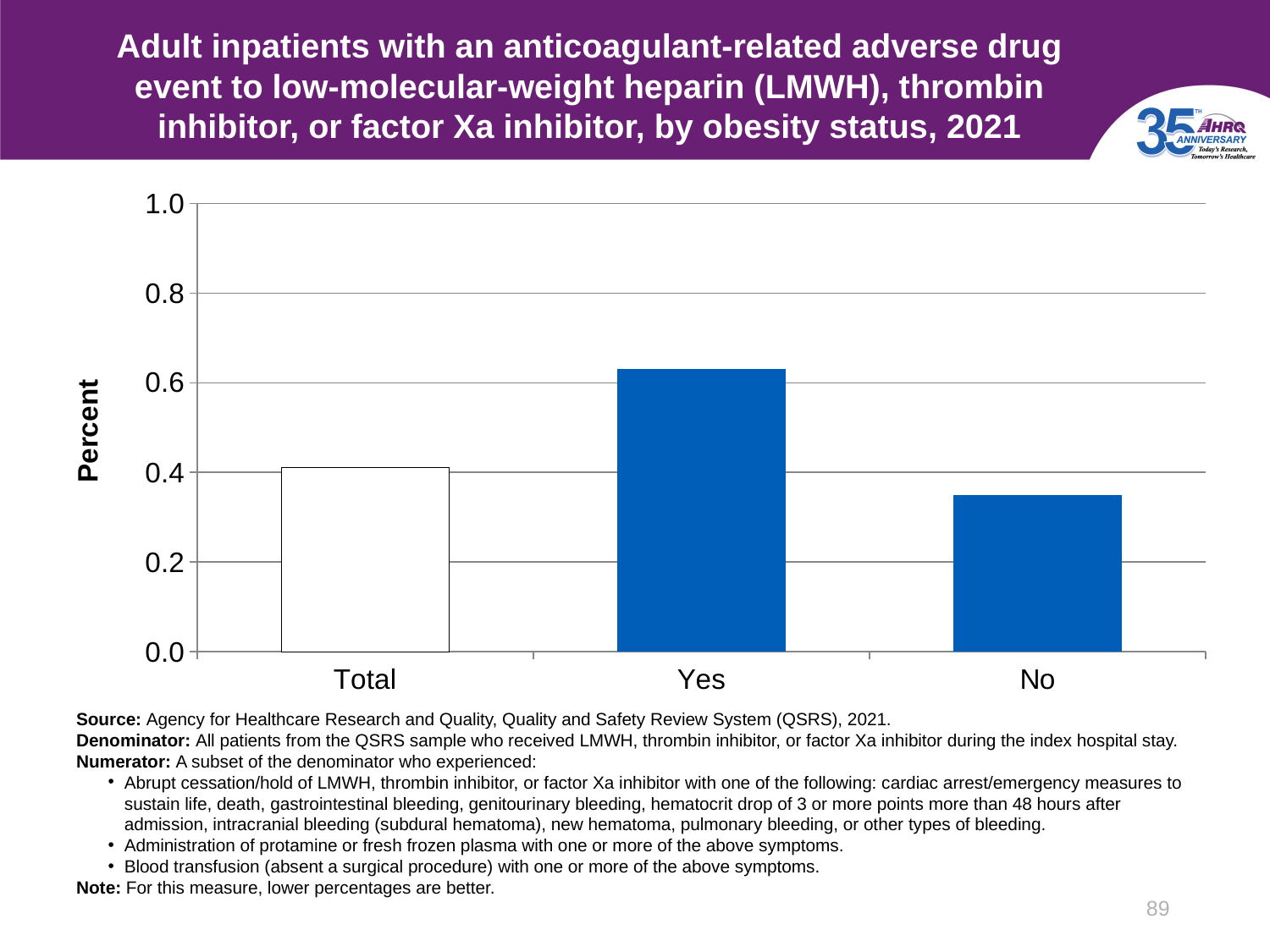
Which category has the lowest value in the chart? No Is the value for No greater or less than 0.2? greater Which is larger, the value for Yes or the value for No? Yes Is the value for No greater or less than 0.4? less Which is larger, the value for Total or the value for Yes? Yes How many categories are shown on the x axis of the chart? 3 Is the value for Yes greater or less than 0.6? greater What kind of chart is shown on the slide? bar chart Which category has the highest value in the chart? Yes What is the label on the vertical axis of the chart? Percent